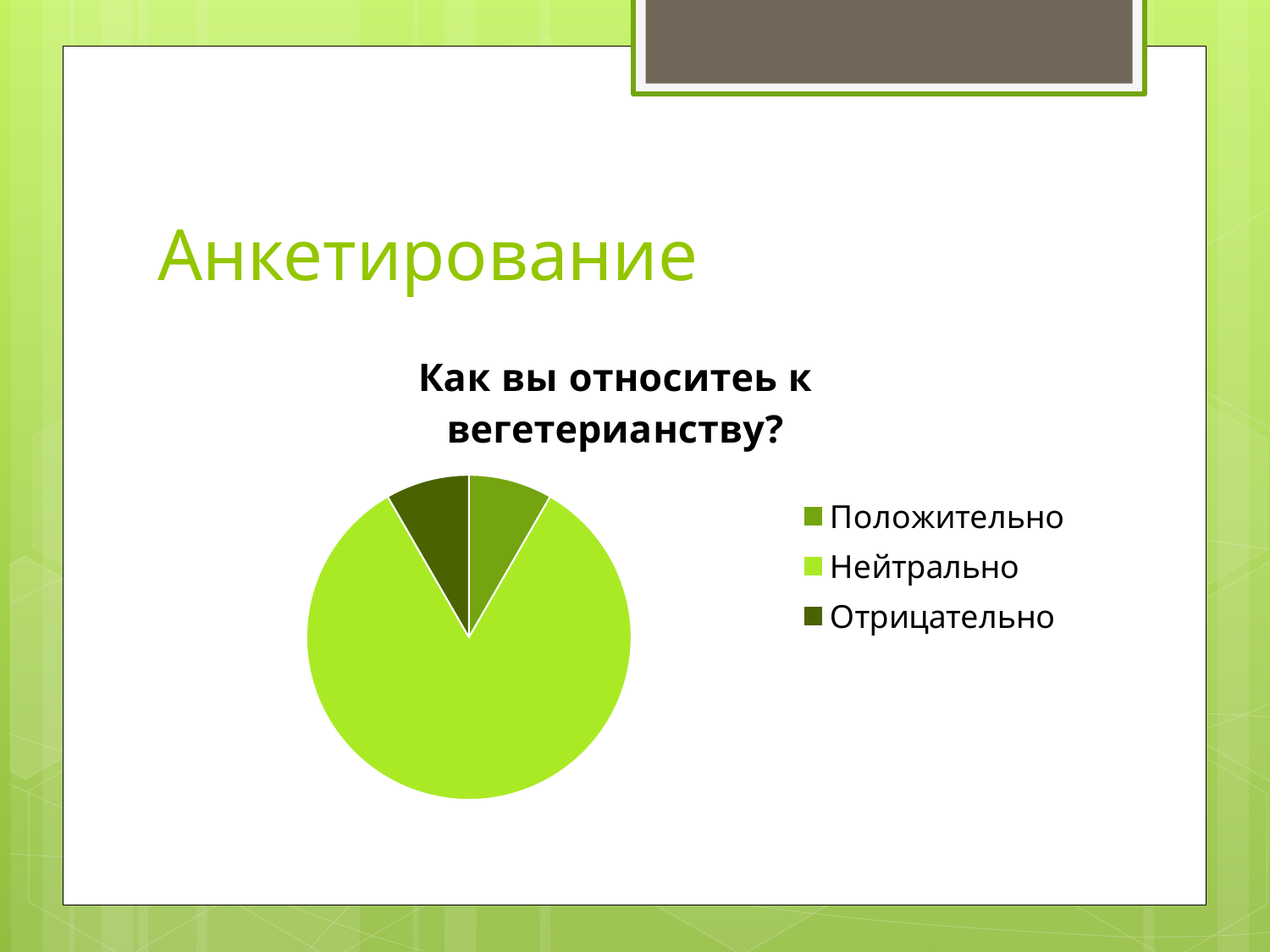
Which legend entry is shown with the darkest green colour? Отрицательно What is the title of the pie chart? Как вы относитеь к вегетерианству? Which category has the largest slice in the pie chart? Нейтрально Which slice is larger, Нейтрально or Отрицательно? Нейтрально How many slices does the pie chart have? 3 How many entries does the legend of the pie chart list? 3 Which slice is larger, Нейтрально or Положительно? Нейтрально What kind of chart is shown on the slide? pie chart